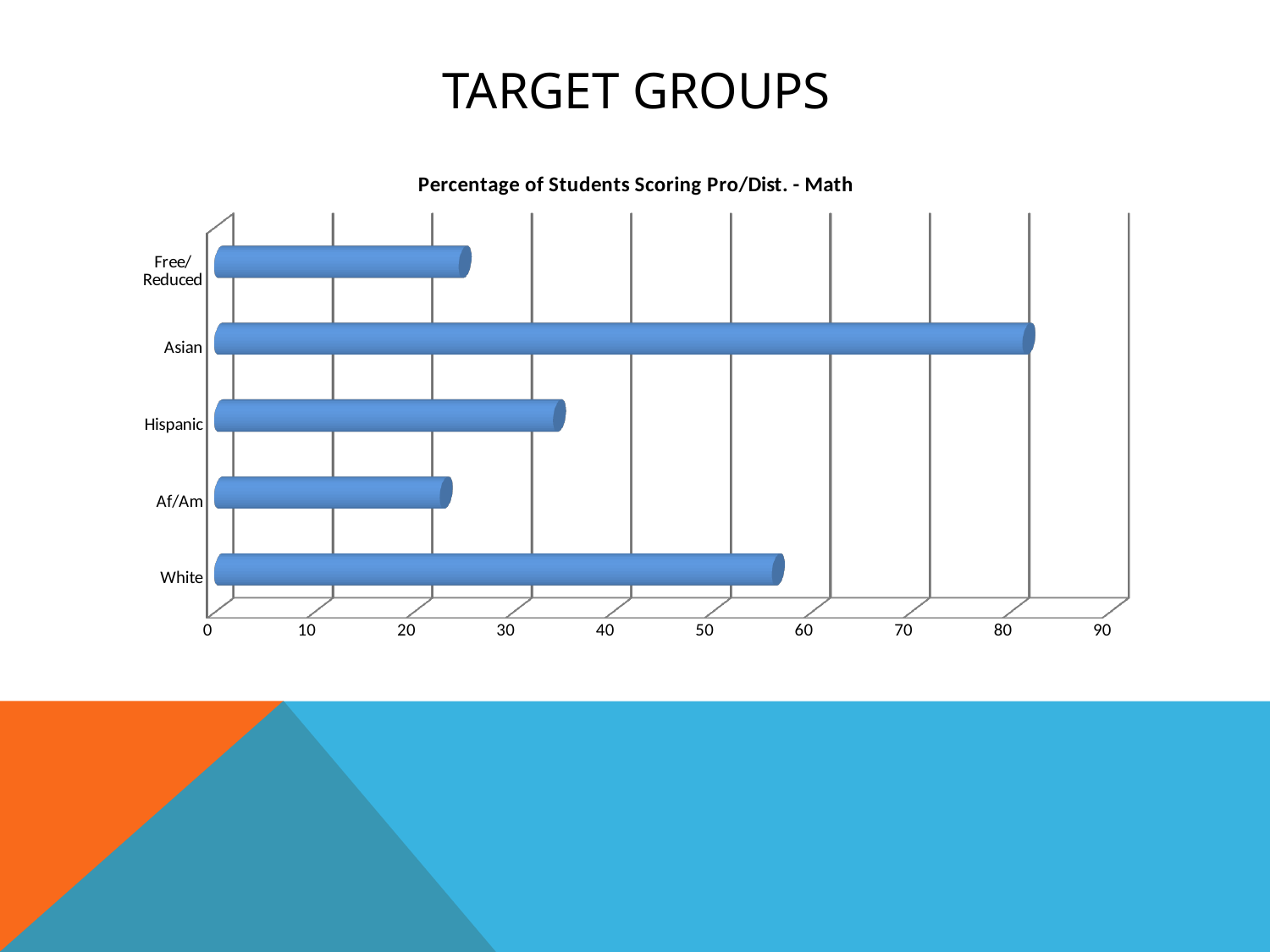
What type of chart is shown on the slide? bar chart Is the value for Af/Am greater or less than 30? less Is the value for Hispanic greater or less than 30? greater Which is larger, the value for White or the value for Hispanic? White Is the value for Free/Reduced greater or less than 30? less What is the maximum value shown on the horizontal axis? 90 Which category has the highest percentage of students scoring Pro/Dist. in Math? Asian What is the title of the chart? Percentage of Students Scoring Pro/Dist. - Math Which is larger, the value for Hispanic or the value for Af/Am? Hispanic How many categories are shown in the chart? 5